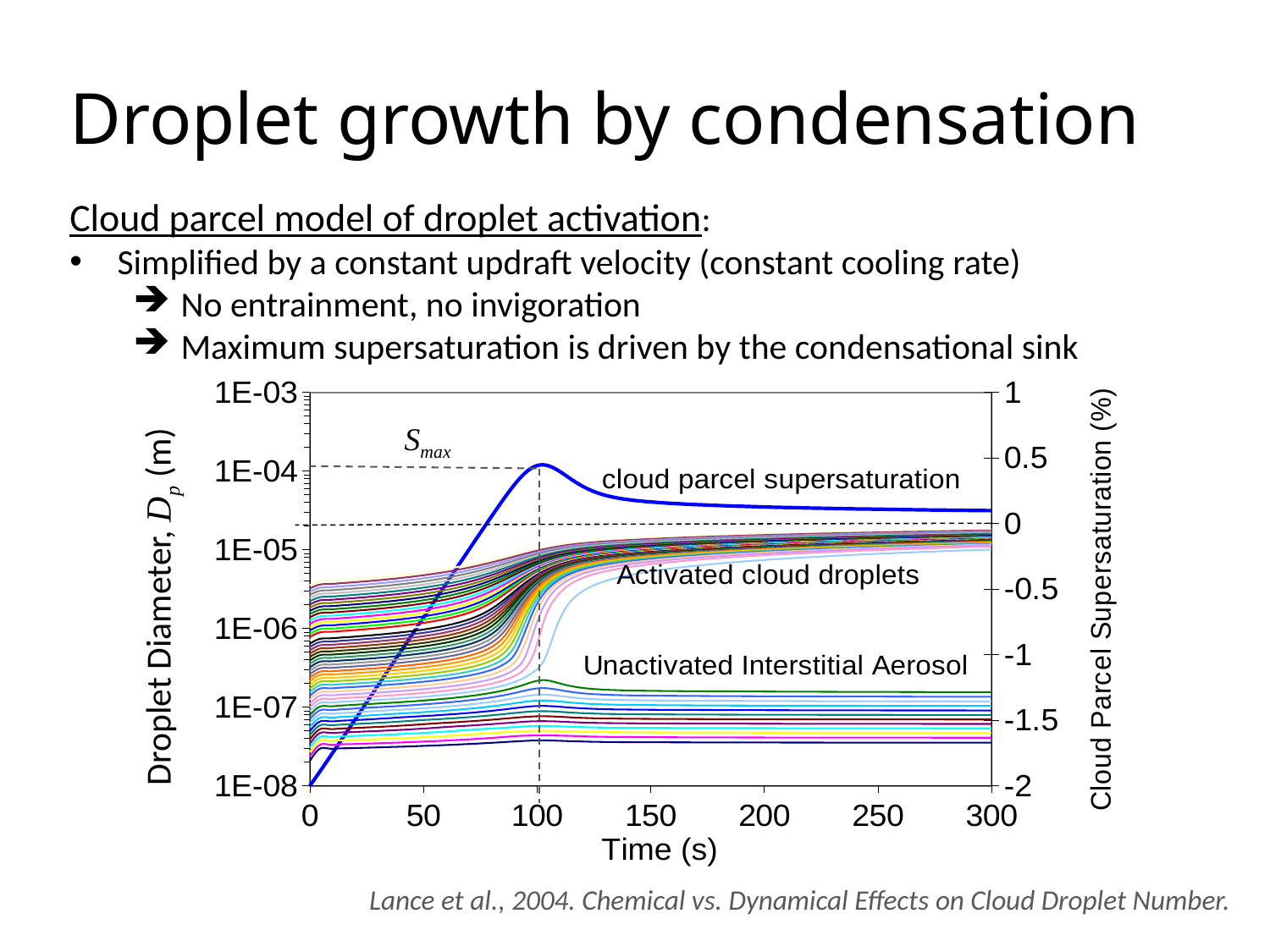
Is the cloud parcel supersaturation at 300 s greater or less than 0.5? less Is the cloud parcel supersaturation at 100 s greater or less than 0? greater What is the label of the right-hand y axis of the chart? Cloud Parcel Supersaturation (%) At 300 s, which group has the larger droplet diameters: the activated cloud droplets or the unactivated interstitial aerosol? Activated cloud droplets What kind of chart is shown on the slide? line chart Does the cloud parcel supersaturation rise or fall between 100 s and 300 s? fall At 300 s, are the diameters of the activated cloud droplets greater or less than 1E-06 m? greater What is the label of the x axis of the chart? Time (s) At what time (s) does the dashed vertical line marking Smax fall? 100 Does the cloud parcel supersaturation rise or fall between 0 s and 100 s? rise